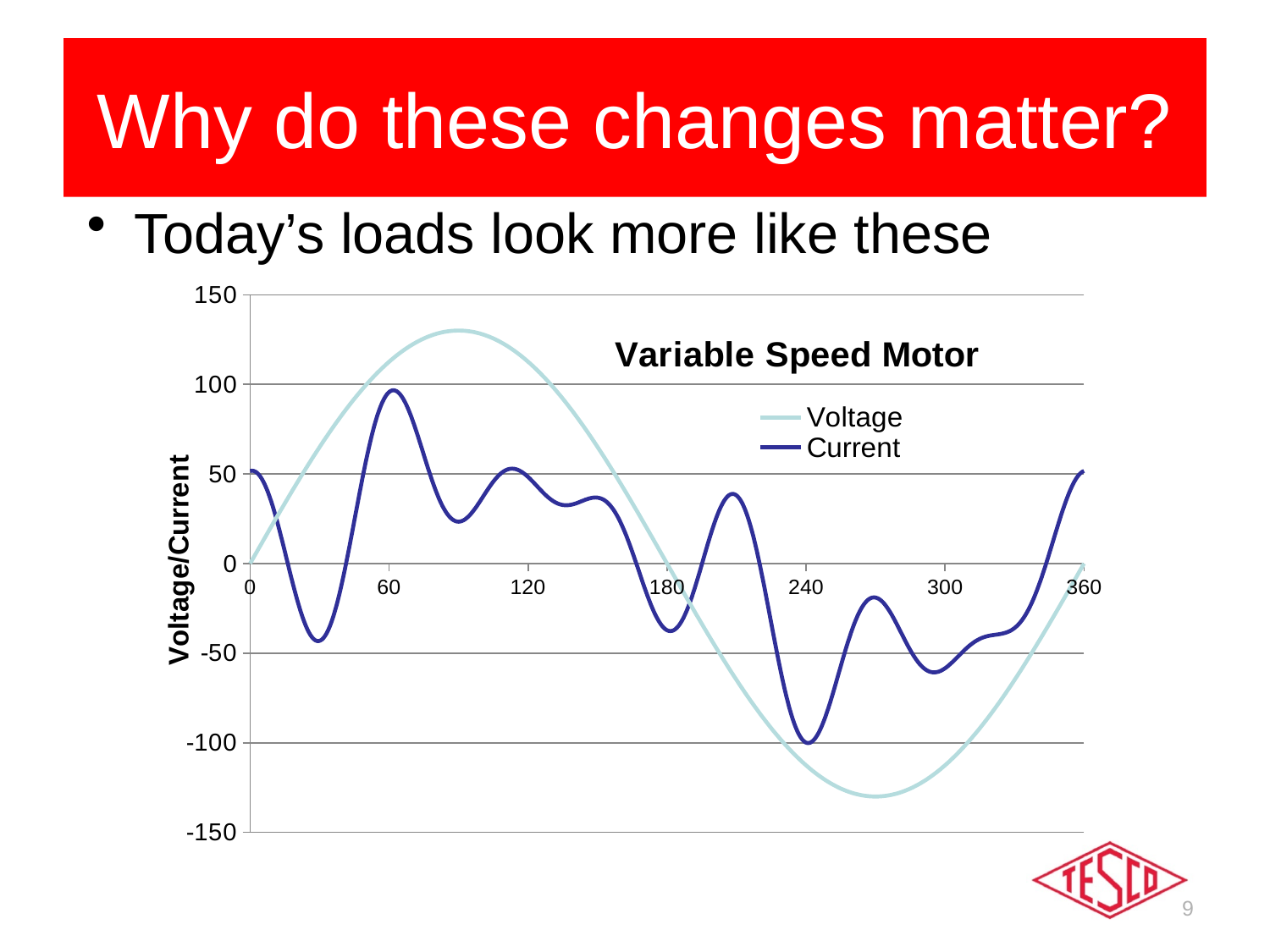
What is the value of the Voltage series at 180 on the x axis? 0 What is the title of the chart? Variable Speed Motor Is the value of the Current series at 270 greater or less than -50? greater Does the Voltage series rise or fall between 90 and 270 on the x axis? fall Is the value of the Voltage series at 90 greater or less than 100? greater Is the value of the Voltage series at 270 greater or less than -100? less How many series does the legend list? 2 What kind of chart is shown on the slide? line chart What is the value of the Voltage series at 360 on the x axis? 0 What is the label on the vertical axis of the chart? Voltage/Current At 90 on the x axis, which series has the larger value, Voltage or Current? Voltage